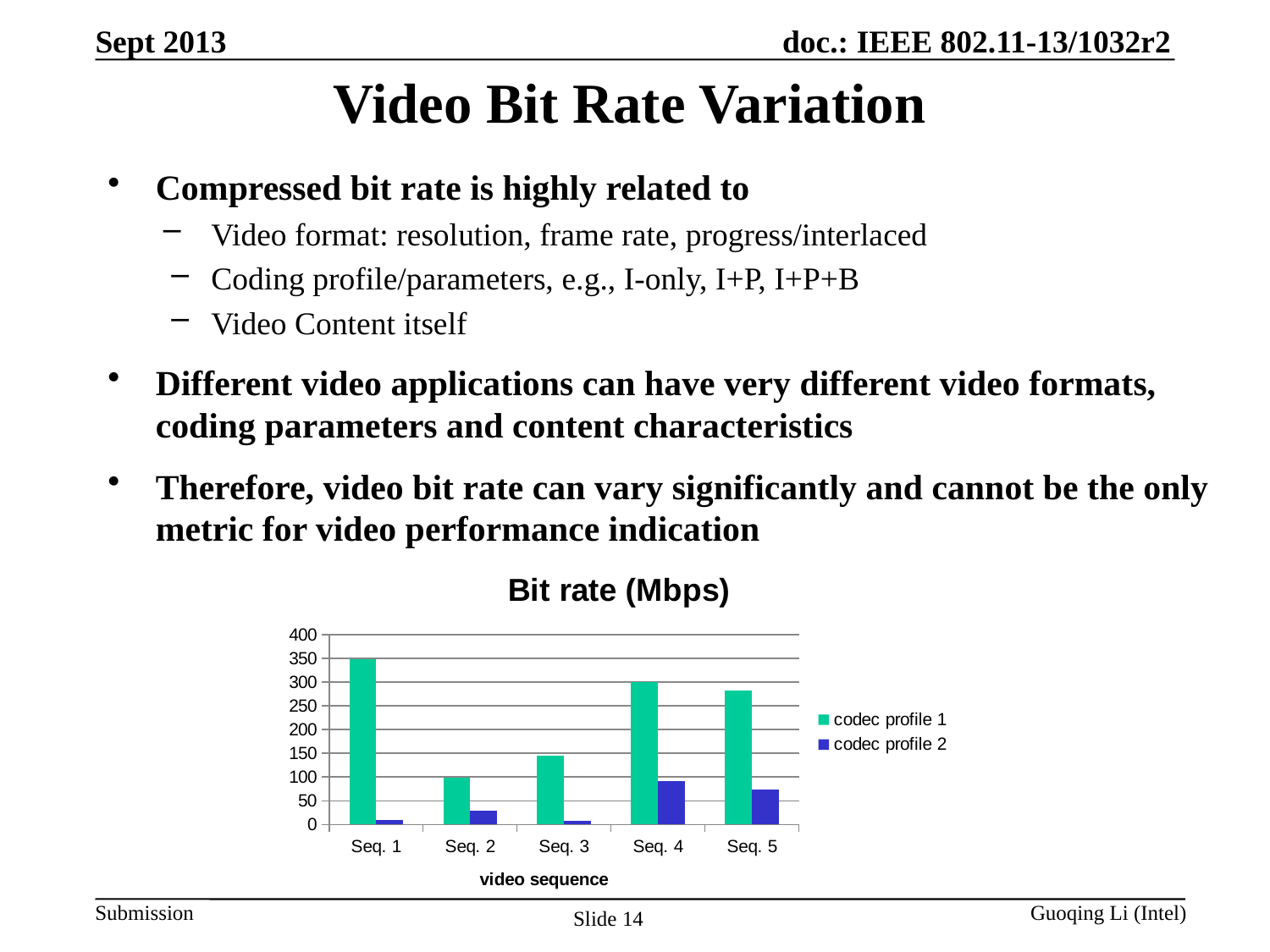
How many video sequences are shown on the x axis of the chart? 5 Which video sequence has the lowest bit rate for codec profile 1? Seq. 2 Is the codec profile 1 bit rate for Seq. 2 greater or less than 150? less Which video sequence has the highest bit rate for codec profile 2? Seq. 4 How many series does the chart legend list? 2 What is the title of the chart? Bit rate (Mbps) For Seq. 3, which series has the larger bit rate, codec profile 1 or codec profile 2? codec profile 1 What kind of chart is shown on the slide? bar chart Is the codec profile 1 bit rate for Seq. 1 greater or less than 300? greater Which video sequence has the highest bit rate for codec profile 1? Seq. 1 What is the x-axis label of the chart? video sequence